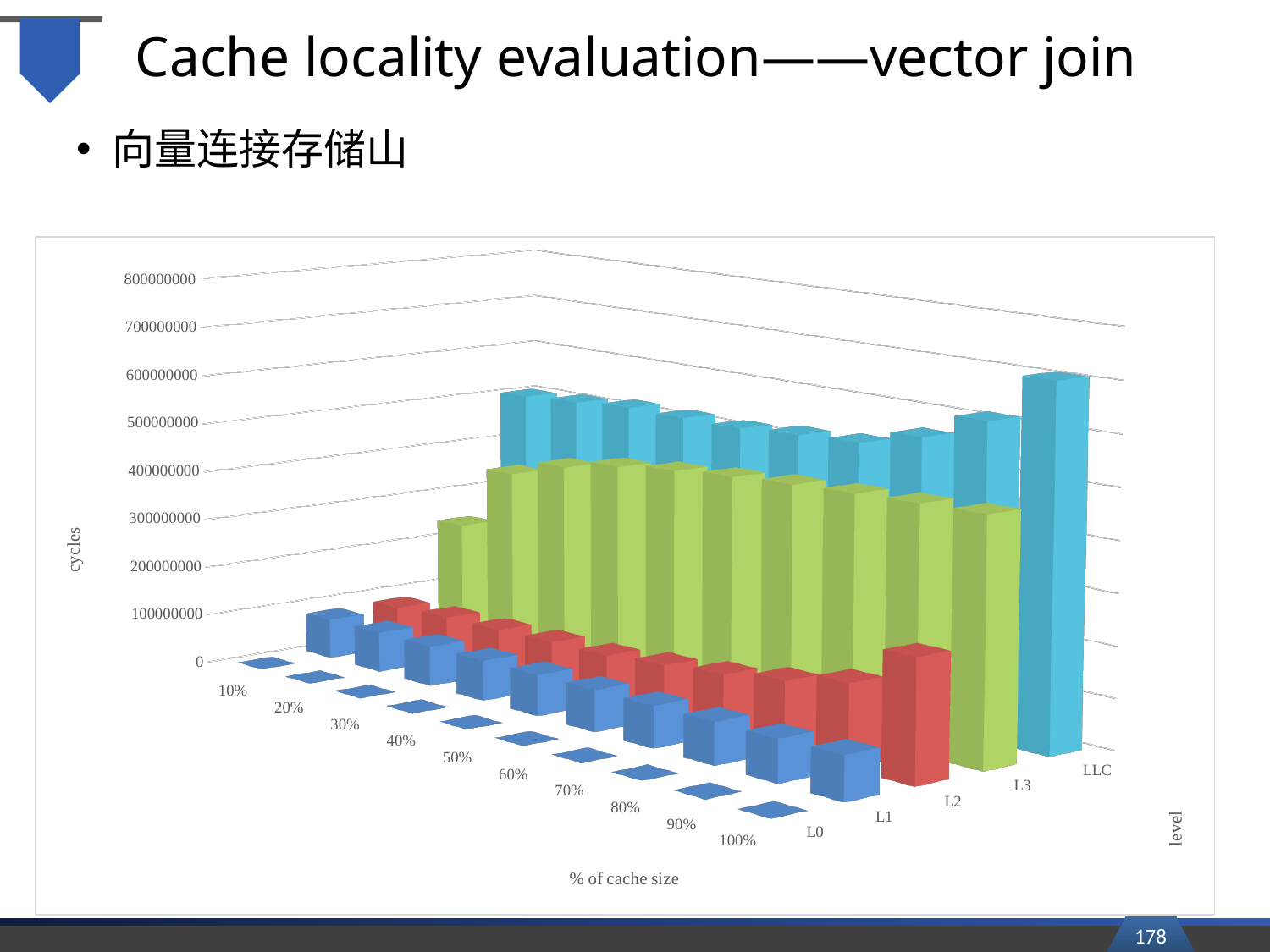
What kind of chart is shown on the slide? bar chart What is the title of the vertical axis? cycles Which is larger at 60% of cache size, the value for LLC or the value for L1? LLC Which level has the lowest cycles at 50% of cache size? L0 What is the title of the horizontal axis? % of cache size How many cache levels are shown along the 'level' axis? 5 Is the value for L3 at 50% of cache size greater or less than 100000000? greater Is the value for L0 at 50% of cache size greater or less than 100000000? less Is the value for LLC at 100% of cache size greater or less than 400000000? greater How many '% of cache size' categories are shown along the x axis? 10 Which level has the highest cycles at 100% of cache size? LLC Which is larger at 30% of cache size, the value for L3 or the value for L2? L3